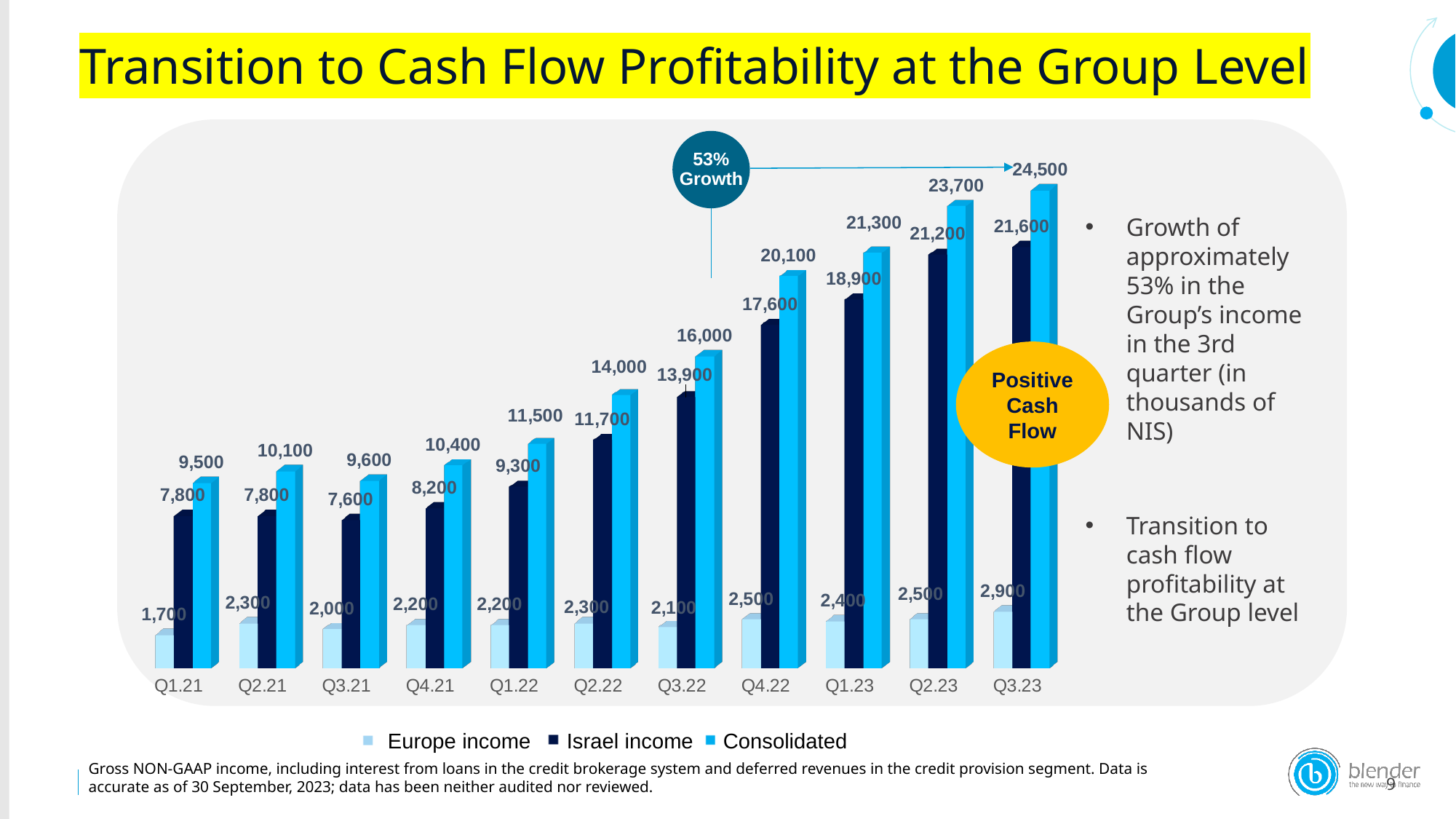
What is the difference between Israel income and Europe income in Q3.23? 18,700 In which quarter is the Europe income value lowest? Q1.21 What is the Europe income value for Q1.21? 1,700 What kind of chart is shown on the slide? Bar chart How many series does the legend list? 3 What is the Consolidated value for Q3.23? 24,500 How many quarters are shown on the x axis? 11 What is the Israel income value for Q4.22? 17,600 In which quarter is the Israel income value lowest? Q3.21 What is the difference between the Consolidated values for Q3.23 and Q2.23? 800 Which quarter has the larger Israel income value, Q1.22 or Q2.22? Q2.22 In which quarter is the Consolidated value highest? Q3.23